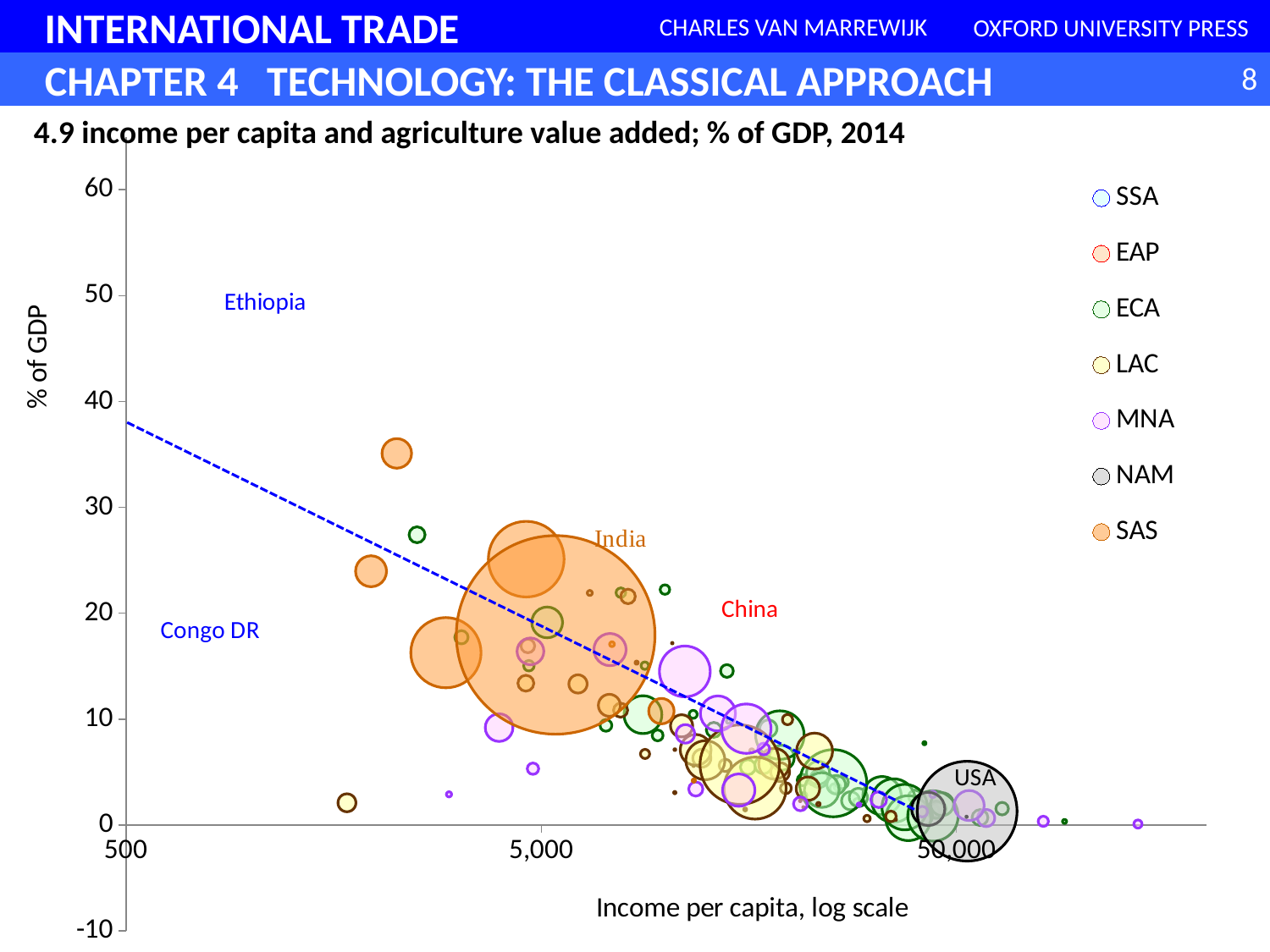
Is the % of GDP value for the USA greater or less than 10? less Is the income per capita for the USA greater or less than 5,000? greater As income per capita increases along the x axis, does agriculture value added as % of GDP generally rise or fall? fall Is the % of GDP value for India greater or less than 10? greater What is the label of the horizontal axis? Income per capita, log scale How many series does the legend list? 7 Which has the higher income per capita, the USA or India? USA What is the title of the chart? 4.9 income per capita and agriculture value added; % of GDP, 2014 Which has the higher % of GDP value, India or the USA? India What kind of chart is shown on the slide? bubble chart